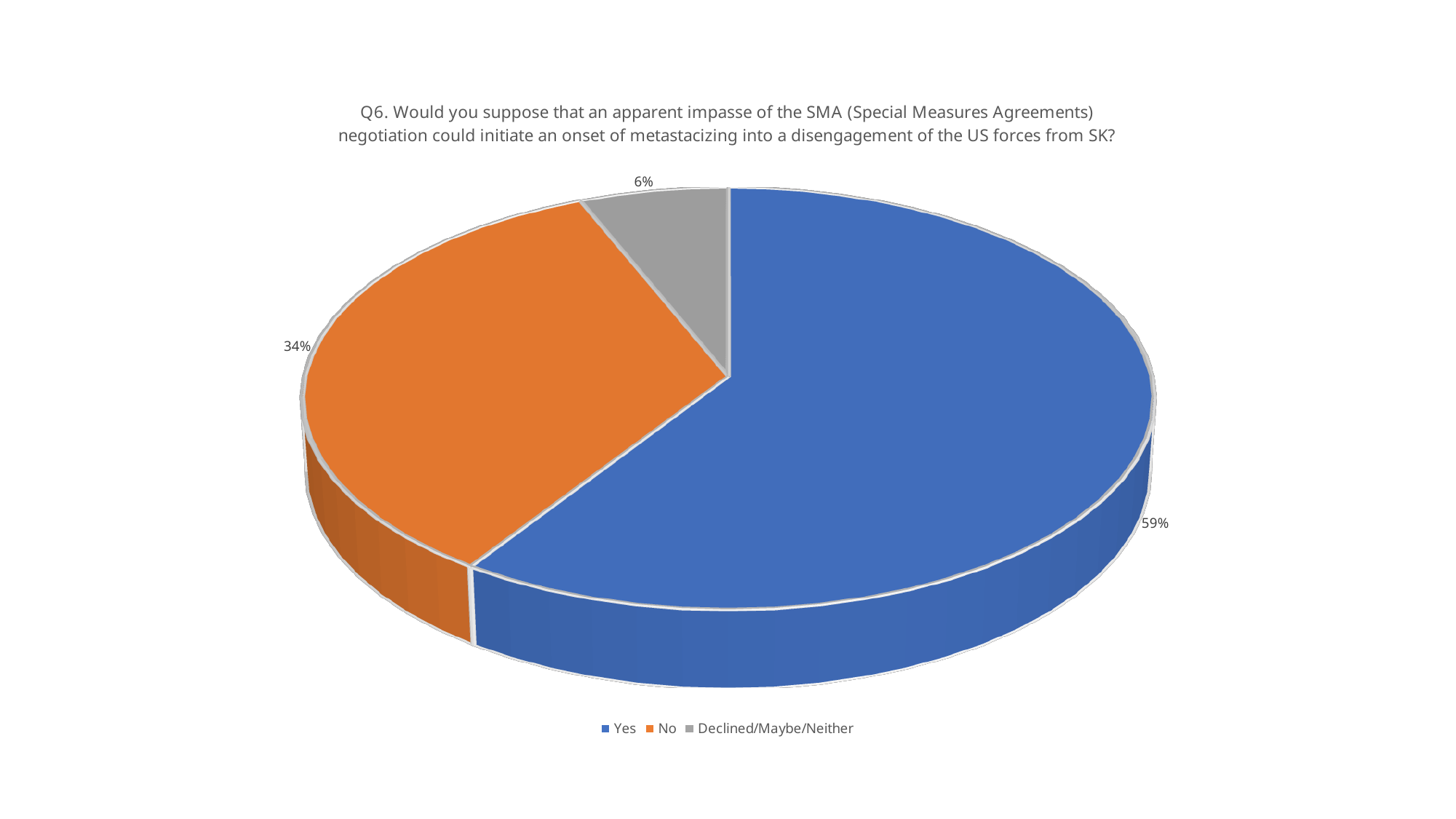
What percentage of respondents answered No? 34% What percentage of respondents answered Yes? 59% What percentage of respondents answered Declined/Maybe/Neither? 6% What is the difference in percentage points between the Yes and No shares? 25 What kind of chart is shown on the slide? pie chart What colour is the slice representing No? orange Which is larger, the share for No or the share for Declined/Maybe/Neither? No What is the difference in percentage points between the No and Declined/Maybe/Neither shares? 28 How many slices does the pie chart have? 3 Which response has the smallest share of the pie? Declined/Maybe/Neither How many entries does the legend list? 3 Which response has the largest share of the pie? Yes